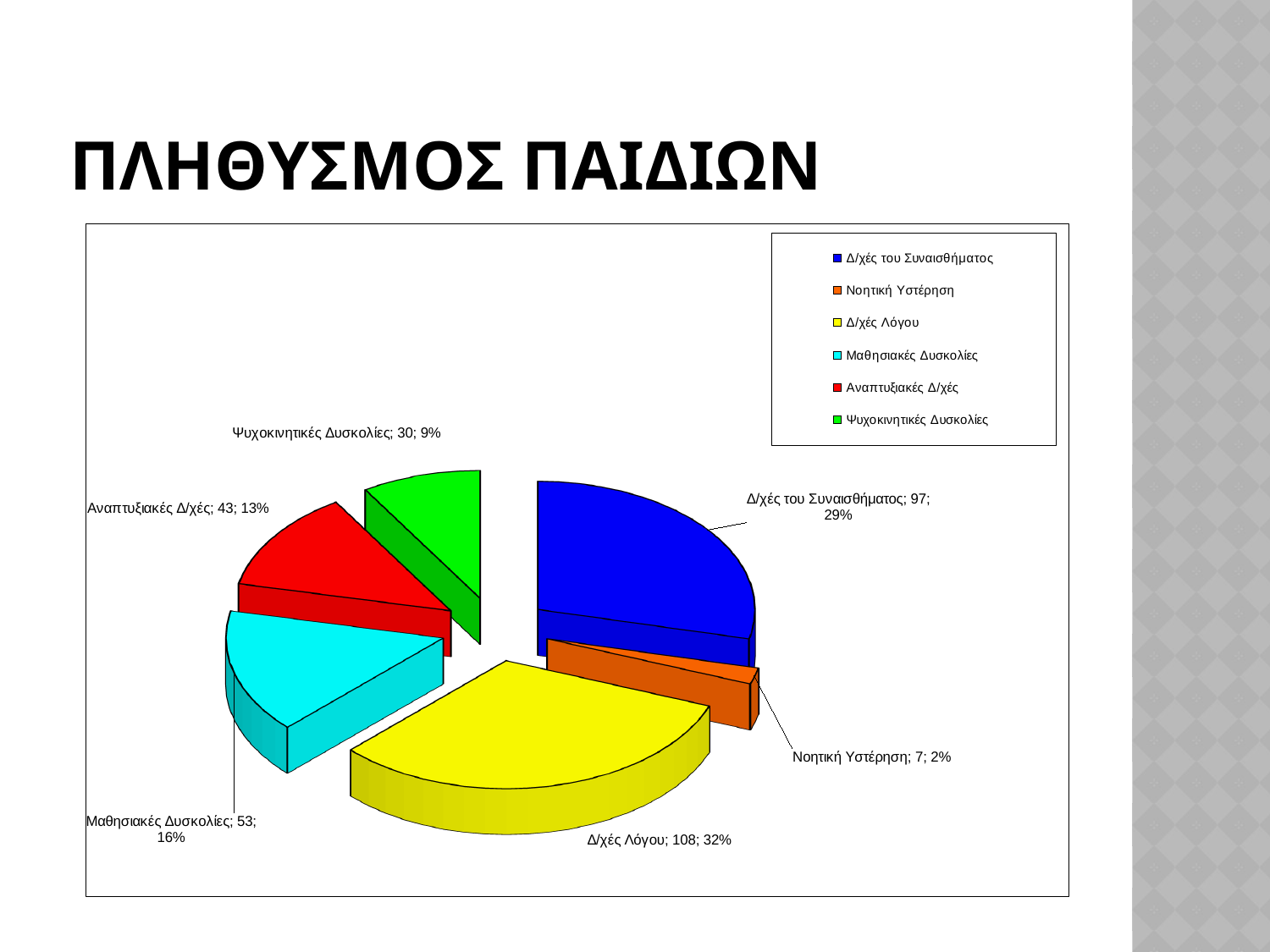
Which is larger, the value for Αναπτυξιακές Δ/χές or the value for Ψυχοκινητικές Δυσκολίες? Αναπτυξιακές Δ/χές What is the value for Δ/χές Λόγου? 108 What is the value for Μαθησιακές Δυσκολίες? 53 Which category has the smallest slice? Νοητική Υστέρηση What percentage share does Δ/χές του Συναισθήματος have? 29% Which category has the largest slice? Δ/χές Λόγου What is the difference between the values for Δ/χές Λόγου and Δ/χές του Συναισθήματος? 11 What percentage share does Ψυχοκινητικές Δυσκολίες have? 9% How many categories does the pie chart have? 6 What kind of chart is shown on the slide? pie chart What is the title of the slide containing the chart? ΠΛΗΘΥΣΜΟΣ ΠΑΙΔΙΩΝ What is the total of all the values shown in the pie chart? 338